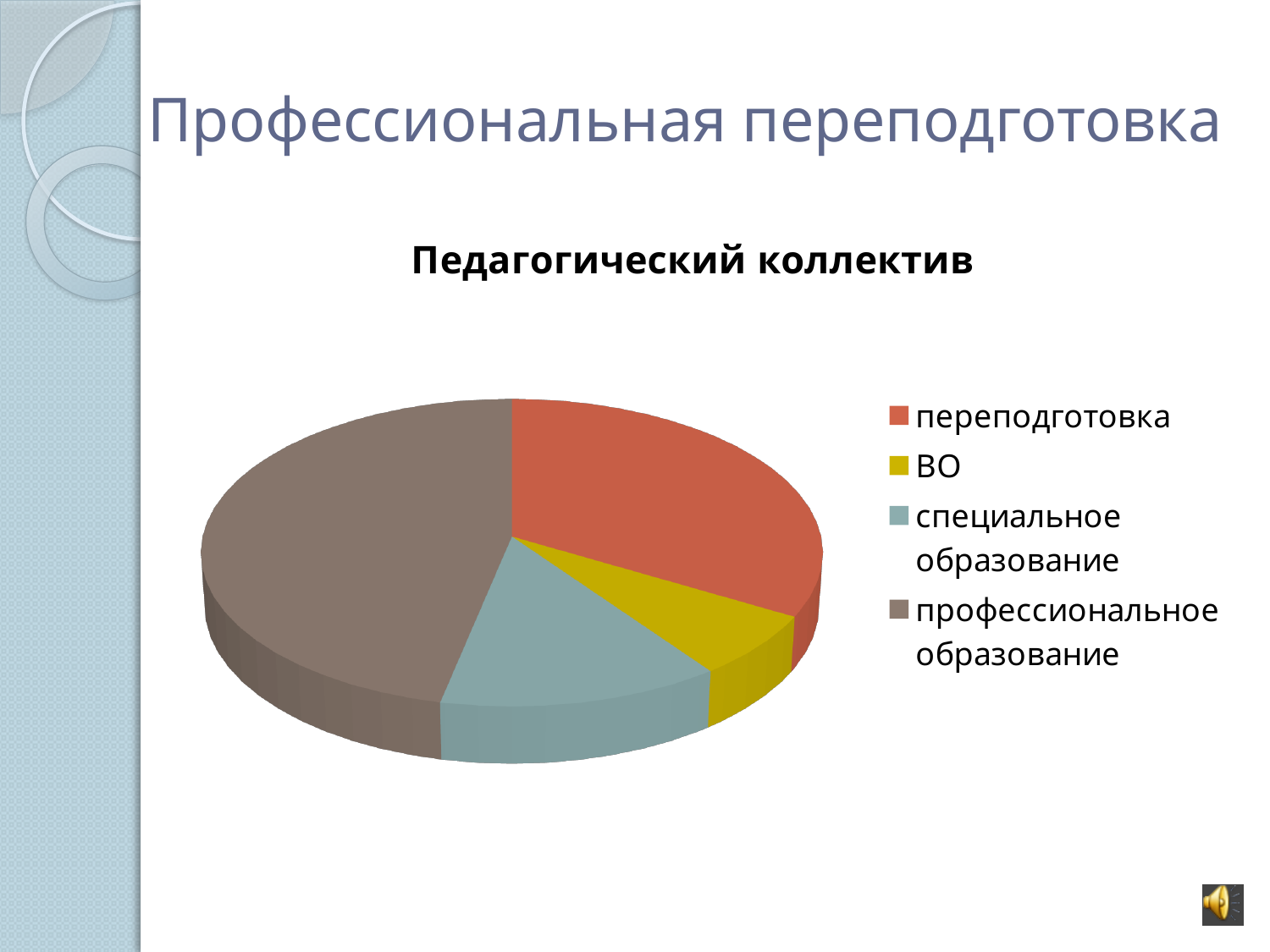
Which category has the largest slice of the pie? профессиональное образование How many entries does the legend list? 4 How many slices does the pie chart have? 4 Which slice is larger: специальное образование or ВО? специальное образование What colour is the slice for ВО? yellow What is the title of the chart? Педагогический коллектив Which slice is larger: профессиональное образование or переподготовка? профессиональное образование Which slice is larger: профессиональное образование or специальное образование? профессиональное образование Which category has the smallest slice of the pie? ВО What kind of chart is shown on the slide? pie chart